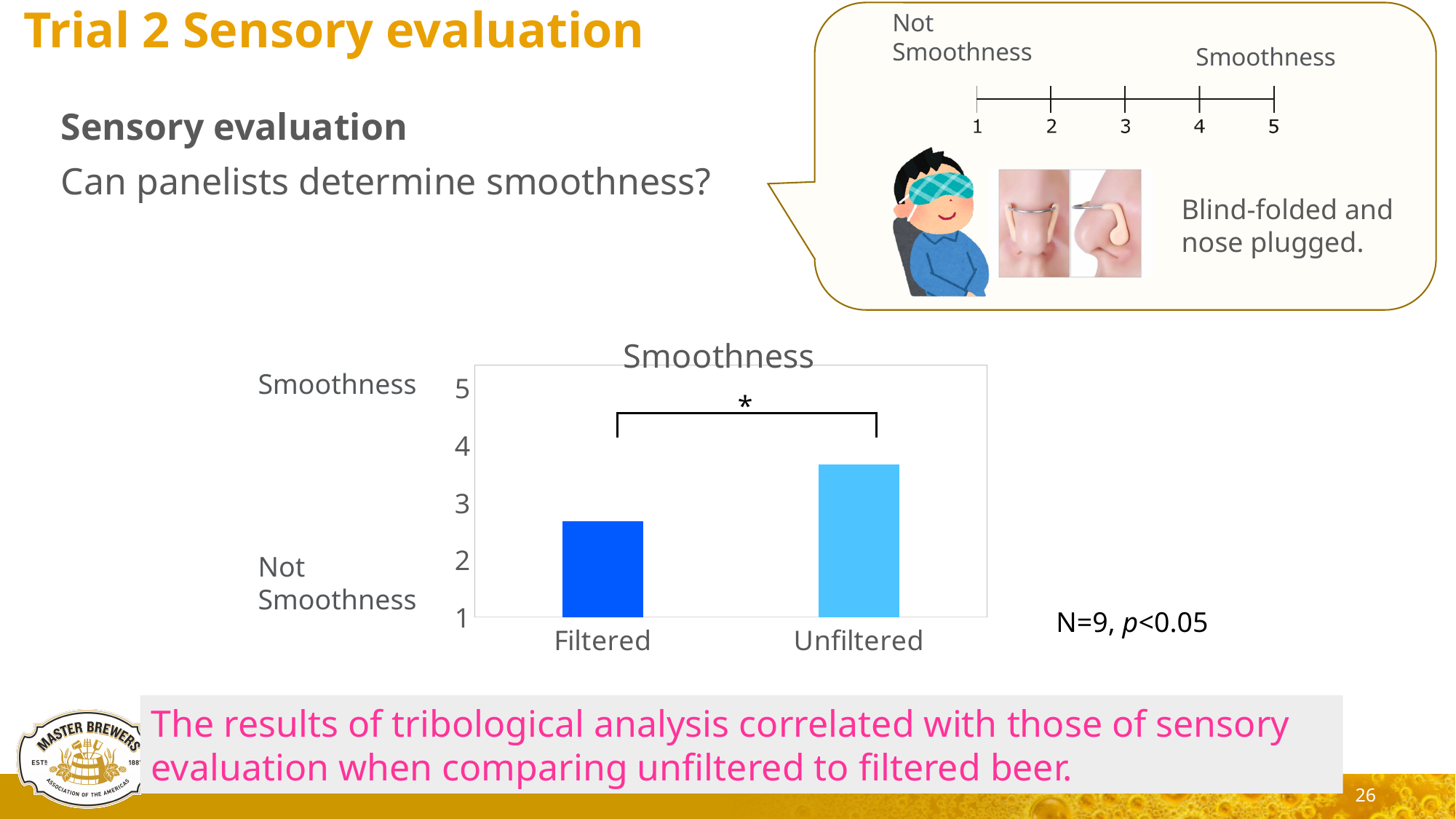
How many categories are plotted on the x axis of the chart? 2 Which category has the lowest smoothness score in the chart? Filtered Is the value for Filtered greater or less than 2? greater Is the value for Filtered greater or less than 3? less What is the maximum value shown on the y axis of the chart? 5 What kind of chart is shown on the slide? bar chart Is the value for Unfiltered greater or less than 3? greater What is the title of the chart? Smoothness Which category has the highest smoothness score in the chart? Unfiltered Which has a larger smoothness score, Filtered or Unfiltered? Unfiltered Do the values rise or fall from Filtered to Unfiltered along the x axis? rise